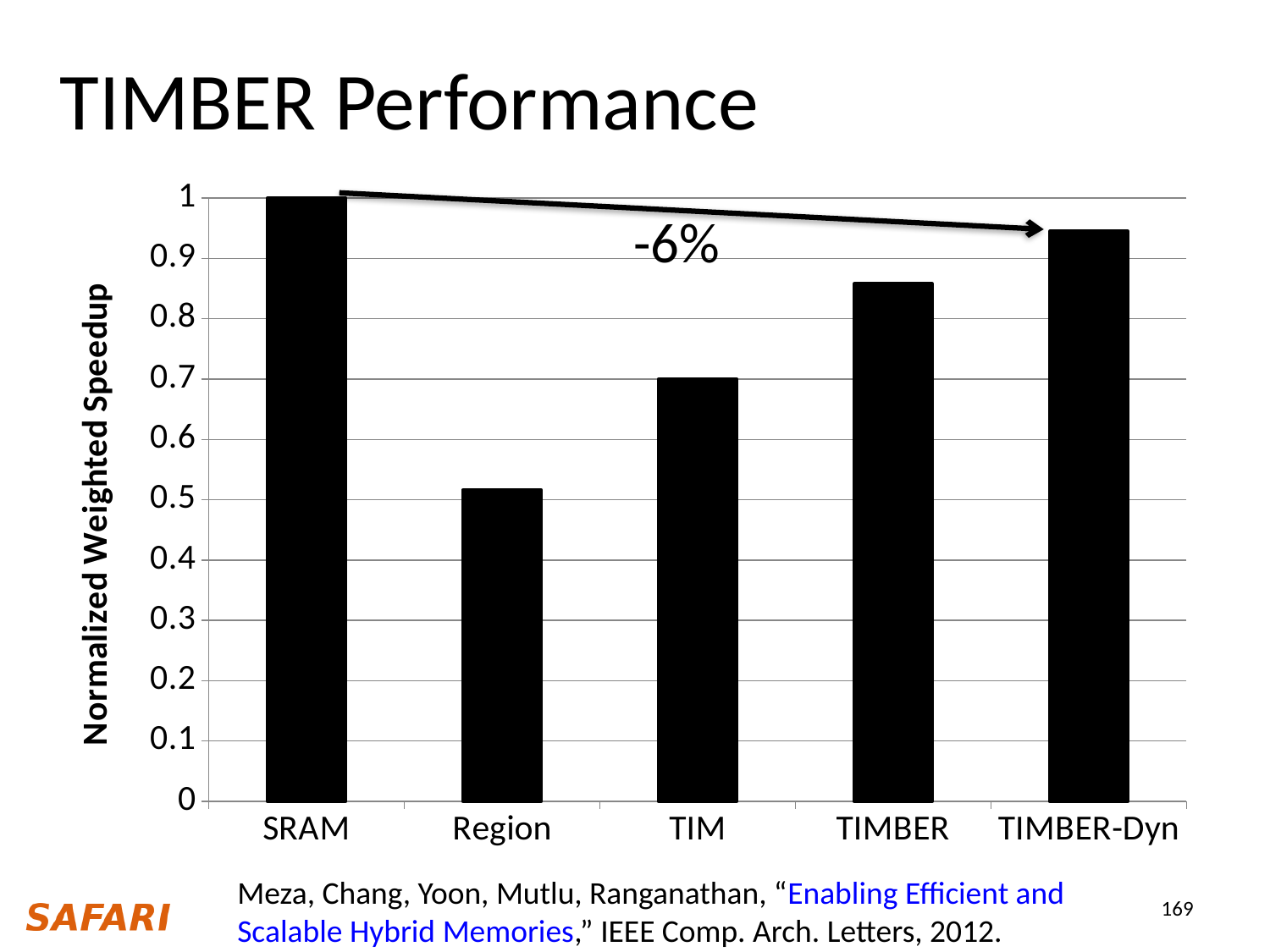
Is the value for Region greater or less than 0.6? less What percentage change does the arrow annotation from SRAM to TIMBER-Dyn indicate? -6% What is the normalized weighted speedup for SRAM? 1 How many categories are shown on the x axis of the chart? 5 Which category has the lowest normalized weighted speedup? Region Is the value for TIMBER greater or less than 0.8? greater What kind of chart is shown on the slide? bar chart Is the value for TIM greater or less than 0.8? less What is the label of the y axis? Normalized Weighted Speedup Which has a higher normalized weighted speedup, TIMBER or TIM? TIMBER Which category has the highest normalized weighted speedup? SRAM